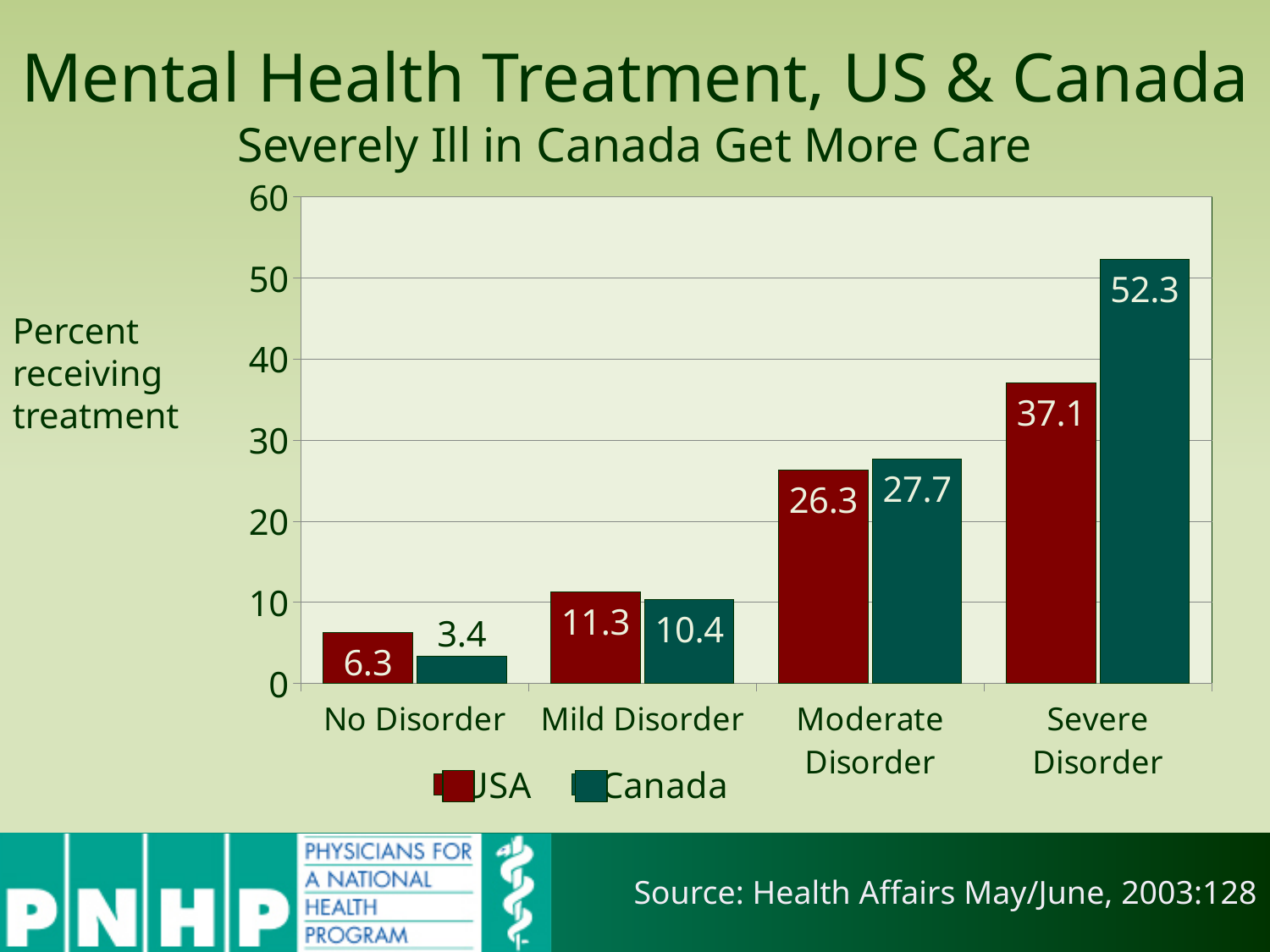
Do the Canada values rise or fall from No Disorder to Severe Disorder? rise How many categories are shown on the x axis? 4 Which is larger in the Mild Disorder category, USA or Canada? USA What is the value for Canada in the Mild Disorder category? 10.4 Is the value for USA in the Moderate Disorder category greater or less than 30? less What is the difference between the Canada and USA values in the Severe Disorder category? 15.2 What kind of chart is shown on the slide? bar chart How many series does the legend list? 2 What is the value for USA in the No Disorder category? 6.3 Which category has the lowest value for the Canada series? No Disorder Which category has the highest value for the USA series? Severe Disorder What is the value for Canada in the Severe Disorder category? 52.3